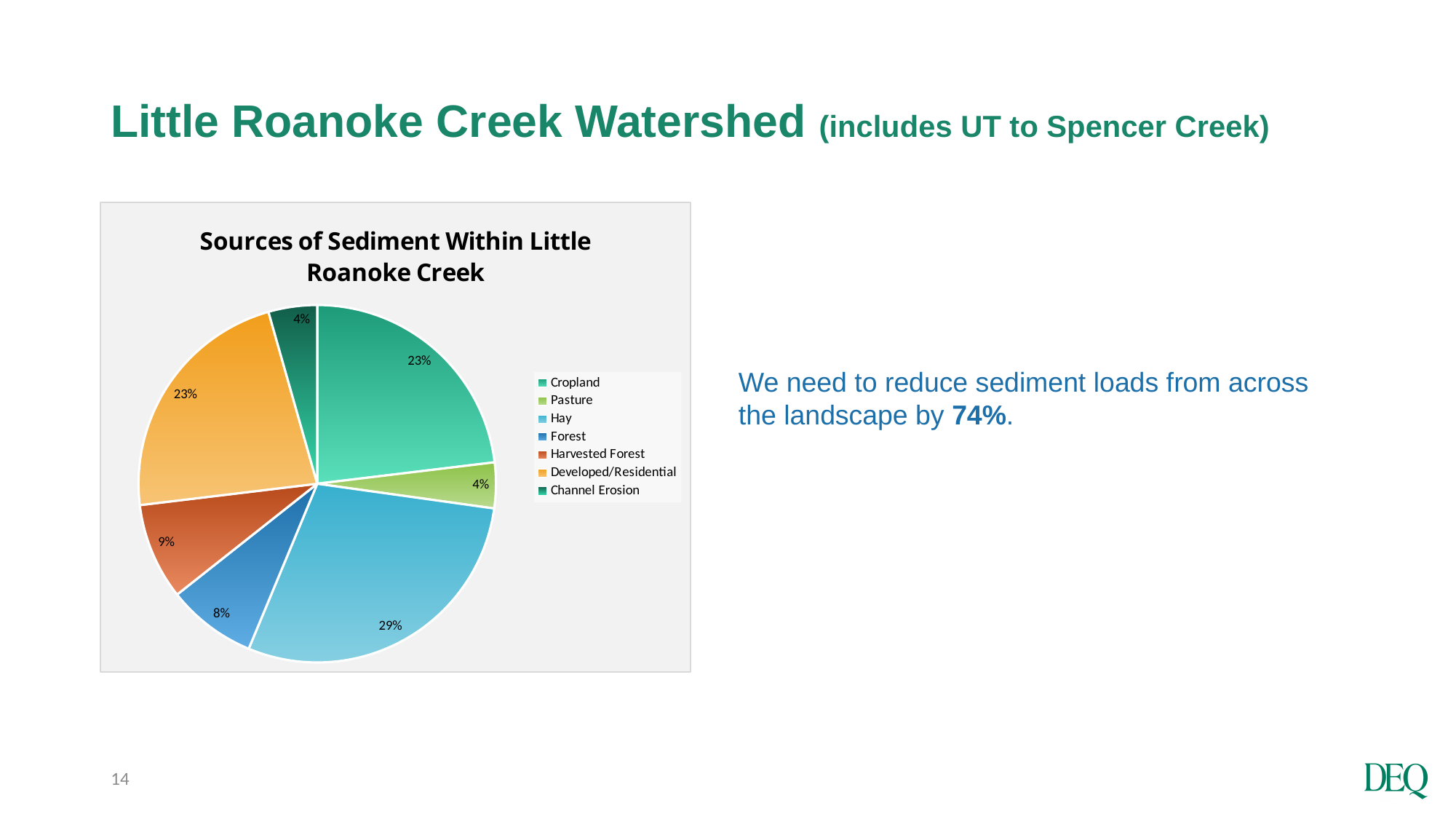
How many sediment source categories does the legend list? 7 What is the difference between the Hay share and the Cropland share? 6% Which sediment source has the largest share of the pie? Hay What share of sediment comes from Cropland? 23% What share of sediment comes from Forest? 8% Which is larger, the share for Hay or the share for Developed/Residential? Hay What is the title of the chart? Sources of Sediment Within Little Roanoke Creek What share of sediment comes from Channel Erosion? 4% What type of chart is shown on the slide? Pie chart What share of sediment comes from Harvested Forest? 9% What share of sediment comes from Developed/Residential? 23% What share of sediment comes from Hay? 29%